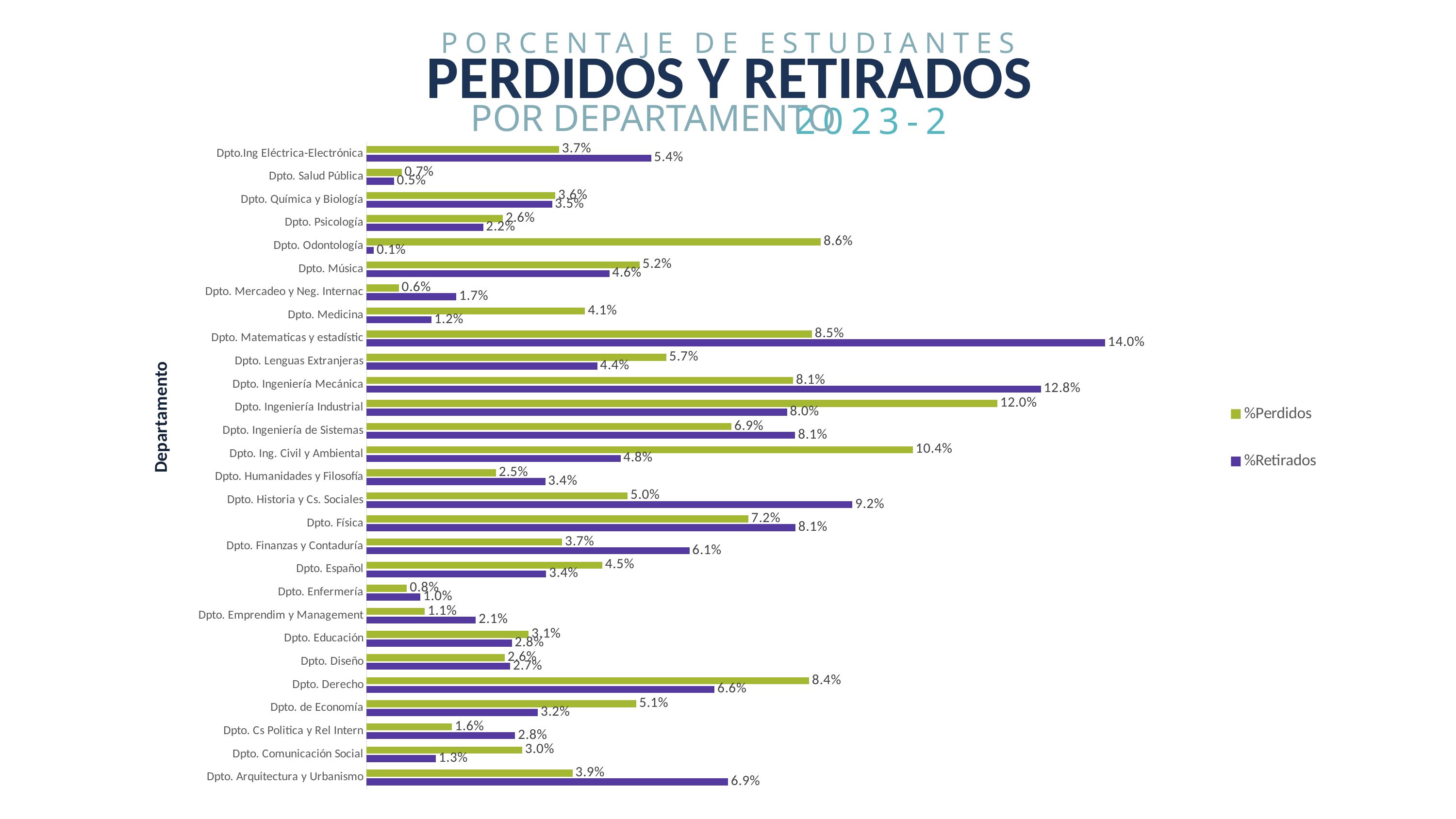
Which department has the highest %Perdidos value? Dpto. Ingeniería Industrial What is the difference between the %Perdidos and %Retirados values for Dpto. Odontología? 8.5 percentage points What is the %Retirados value for Dpto. Historia y Cs. Sociales? 9.2% What is the %Retirados value for Dpto. Ingeniería Mecánica? 12.8% What type of chart is shown on the slide? Bar chart Which department has the lowest %Retirados value? Dpto. Odontología How many series does the legend list? 2 How many departments are shown on the chart? 28 Which department has the highest %Retirados value? Dpto. Matematicas y estadístic Which is larger for Dpto. Ing. Civil y Ambiental, %Perdidos or %Retirados? %Perdidos What is the %Perdidos value for Dpto. Odontología? 8.6% What is the difference between the %Retirados and %Perdidos values for Dpto. Matematicas y estadístic? 5.5 percentage points